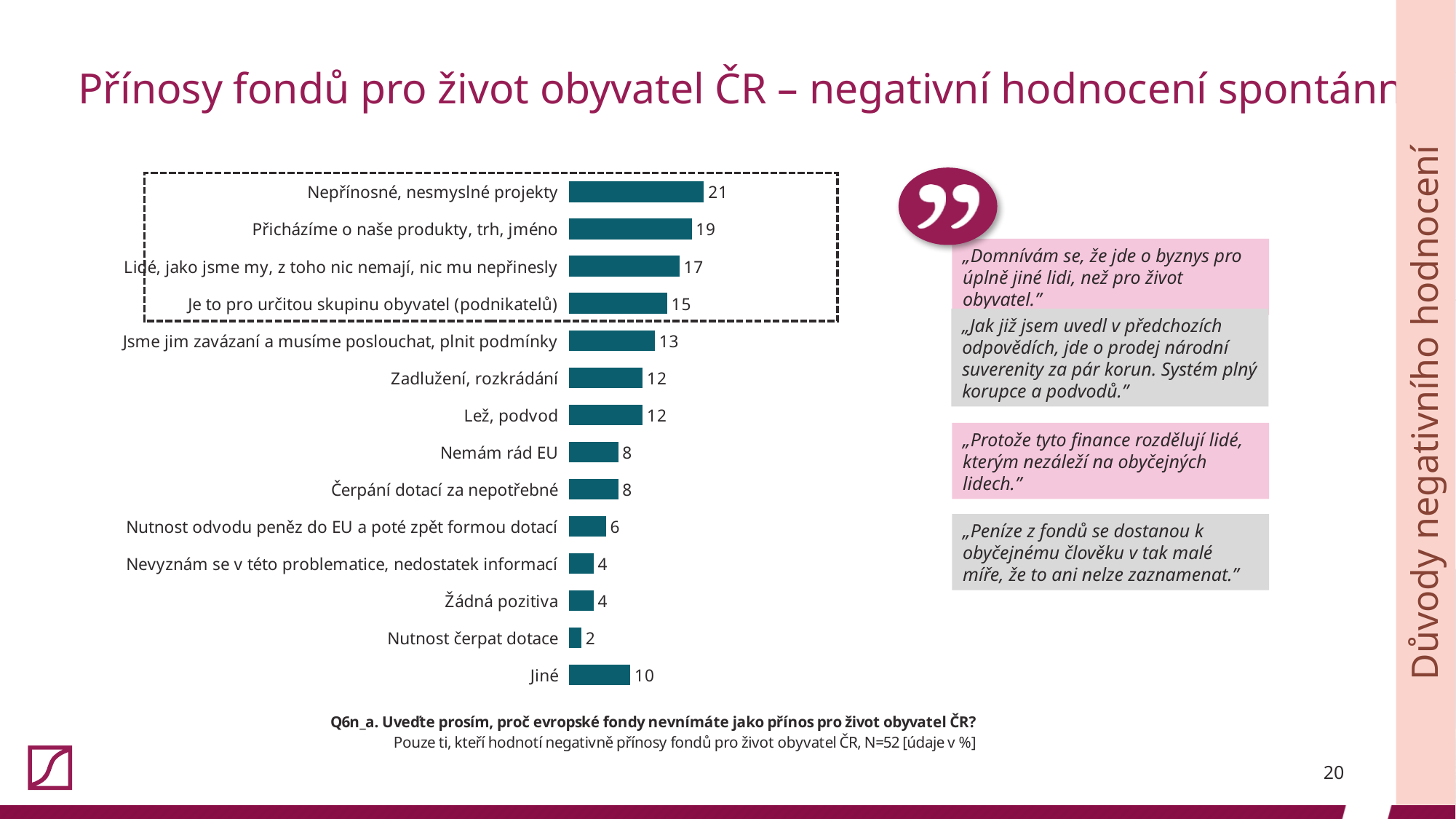
What is the value for "Jiné"? 10 What is the value for "Zadlužení, rozkrádání"? 12 What is the difference between the values for "Přicházíme o naše produkty, trh, jméno" and "Je to pro určitou skupinu obyvatel (podnikatelů)"? 4 What is the value for "Nepřínosné, nesmyslné projekty"? 21 How many categories are enclosed by the dashed box at the top of the chart? 4 Which category has the lowest value? Nutnost čerpat dotace What is the difference between the values for "Nepřínosné, nesmyslné projekty" and "Nutnost čerpat dotace"? 19 How many categories does the chart show? 14 What is the value for "Nutnost odvodu peněz do EU a poté zpět formou dotací"? 6 Which is larger: the value for "Jsme jim zavázaní a musíme poslouchat, plnit podmínky" or the value for "Nemám rád EU"? Jsme jim zavázaní a musíme poslouchat, plnit podmínky What kind of chart is shown on the slide? Bar chart Which category has the highest value? Nepřínosné, nesmyslné projekty